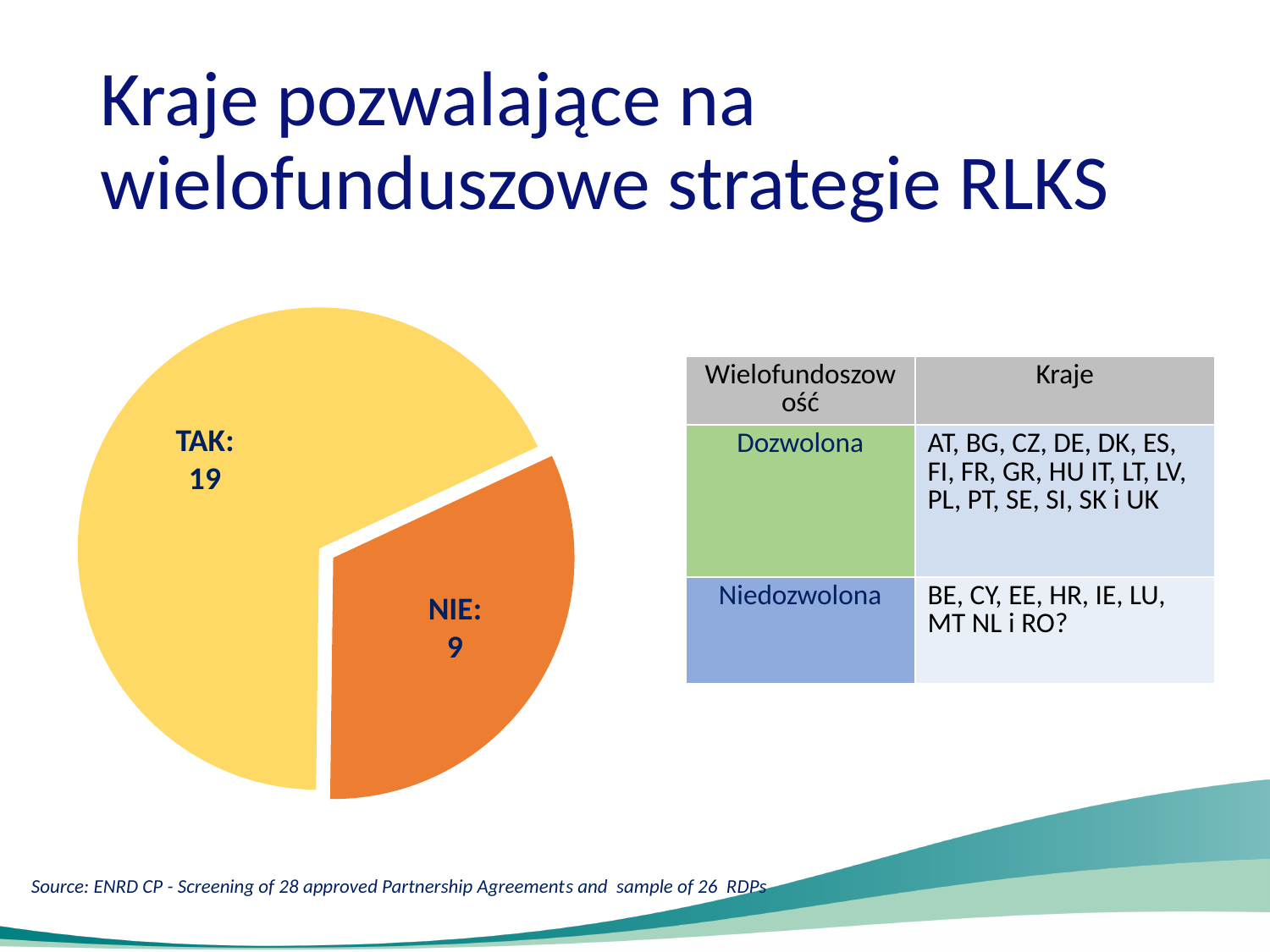
What is the value of the TAK slice in the pie chart? 19 What is the difference between the TAK and NIE values in the pie chart? 10 Which is larger in the pie chart, TAK or NIE? TAK What colour is the TAK slice in the pie chart? Yellow Which slice of the pie chart is the smallest? NIE What is the value of the NIE slice in the pie chart? 9 What colour is the NIE slice in the pie chart? Orange What fraction of the pie chart total does the NIE slice represent? 9/28 What is the total of the two slices in the pie chart? 28 Which slice of the pie chart is the largest? TAK How many slices does the pie chart have? 2 What type of chart is shown on the slide? Pie chart